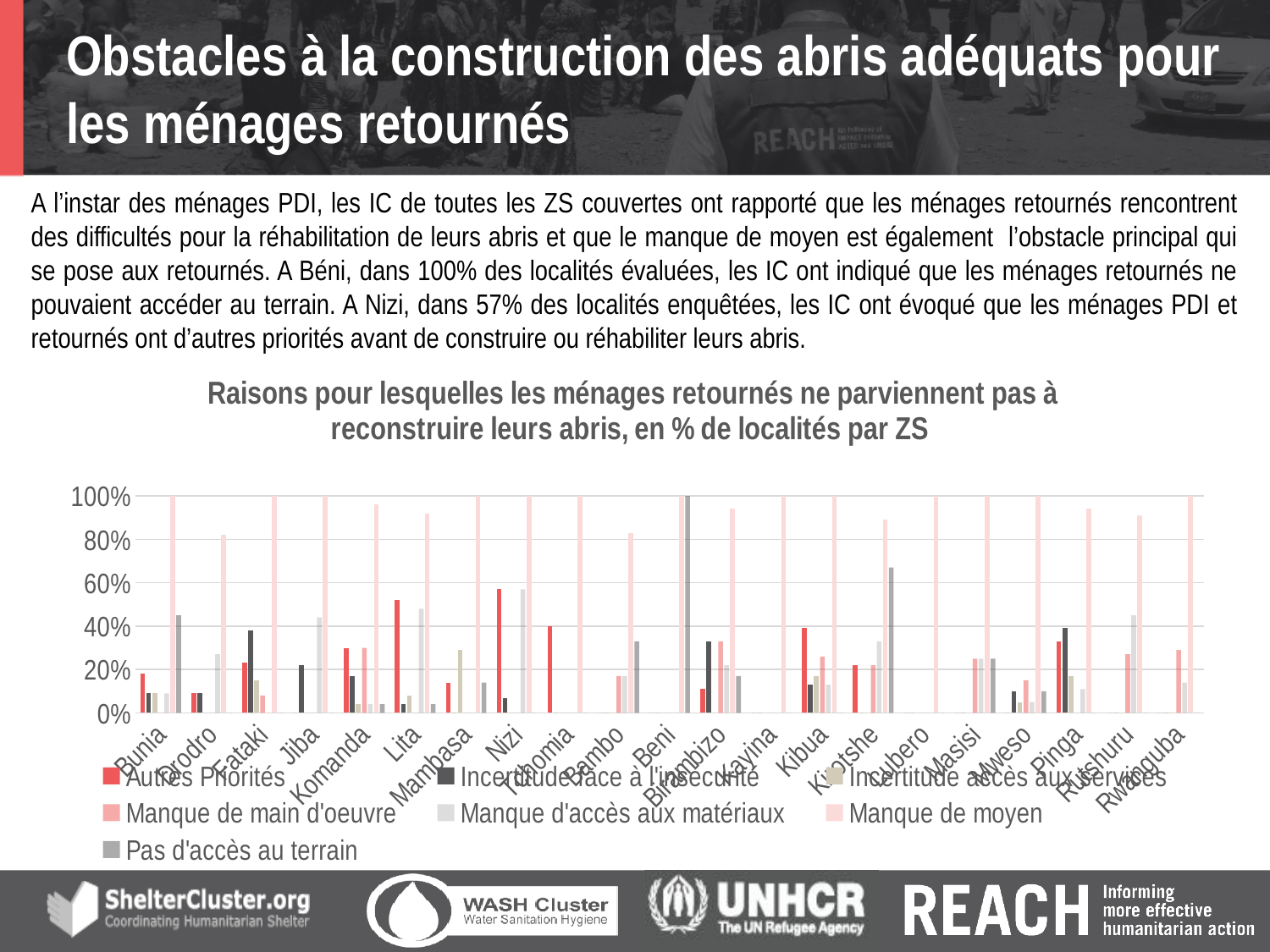
What colour represents 'Autres Priorités' in the chart legend? red Which zone de santé has the highest value for 'Pas d'accès au terrain'? Beni Is the value of 'Autres Priorités' for Mambasa greater or less than 20%? less Which is larger: 'Pas d'accès au terrain' for Beni or 'Pas d'accès au terrain' for Bunia? Beni What is the value of 'Pas d'accès au terrain' for Beni? 100% How many series does the chart legend list? 7 Is the value of 'Autres Priorités' for Lita greater or less than 40%? greater Which series has the highest value for Bunia? Manque de moyen Is the value of 'Manque de moyen' for Rutshuru greater or less than 80%? greater What kind of chart is shown on the slide? bar chart How many zones de santé (categories) are shown along the x axis of the chart? 21 What is the value of 'Manque de moyen' for Bunia? 100%